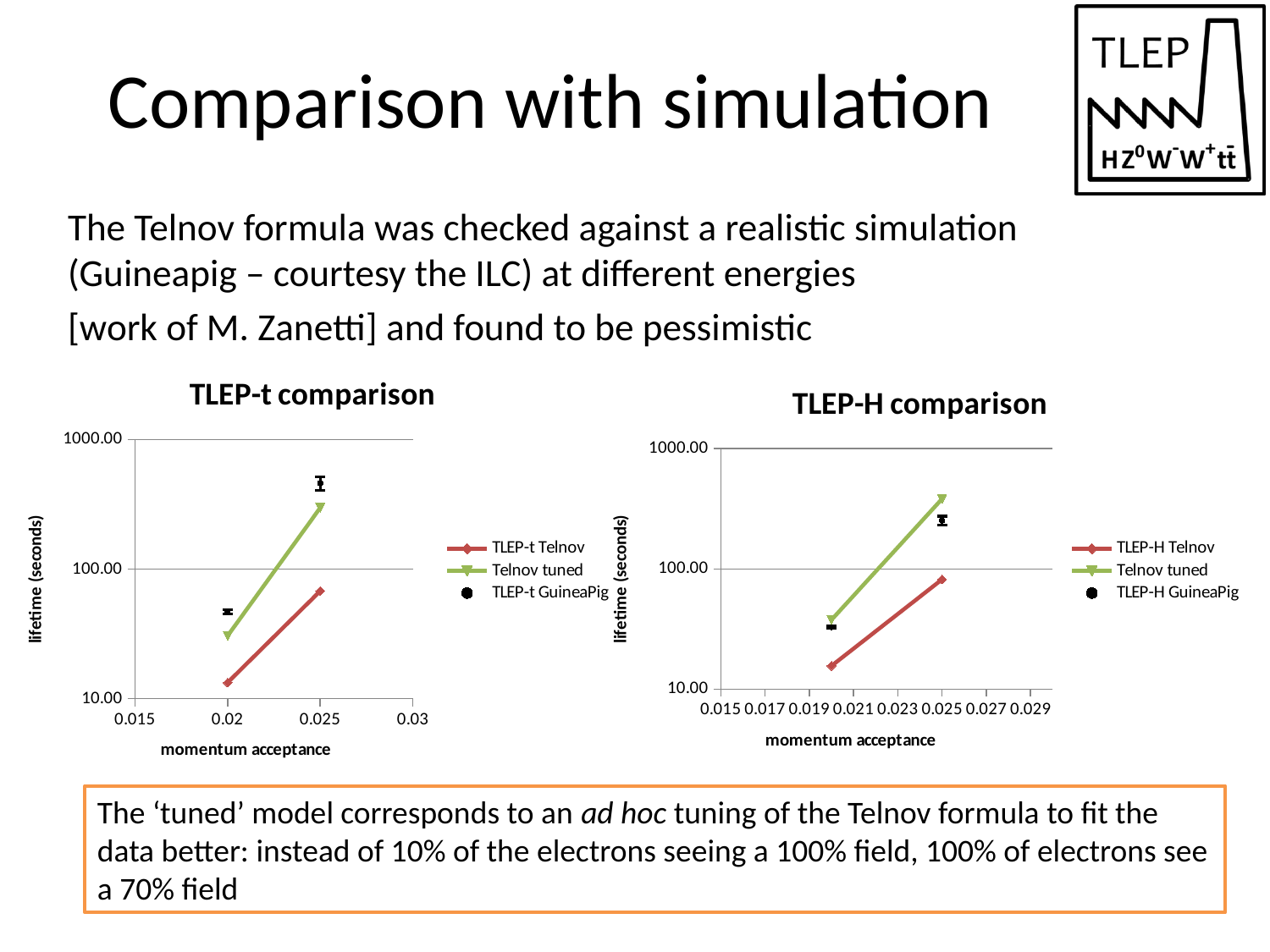
What is the label of the y axis in the 'TLEP-t comparison' chart? lifetime (seconds) What kind of chart is the 'TLEP-t comparison' chart? line chart In the 'TLEP-t comparison' chart, which is larger at momentum acceptance 0.025: TLEP-t GuineaPig or Telnov tuned? TLEP-t GuineaPig How many momentum acceptance values have data points plotted in the 'TLEP-t comparison' chart? 2 What is the label of the x axis in the 'TLEP-H comparison' chart? momentum acceptance How many series does the legend of the 'TLEP-H comparison' chart list? 3 In the 'TLEP-t comparison' chart, is the value of Telnov tuned at momentum acceptance 0.025 greater or less than 100.00? greater In the 'TLEP-t comparison' chart, is the value of TLEP-t Telnov at momentum acceptance 0.025 greater or less than 100.00? less In the 'TLEP-H comparison' chart, does the TLEP-H Telnov series rise or fall as momentum acceptance increases? rise In the 'TLEP-H comparison' chart, is the value of Telnov tuned at momentum acceptance 0.025 greater or less than 100.00? greater In the 'TLEP-H comparison' chart, which is larger at momentum acceptance 0.025: Telnov tuned or TLEP-H GuineaPig? Telnov tuned